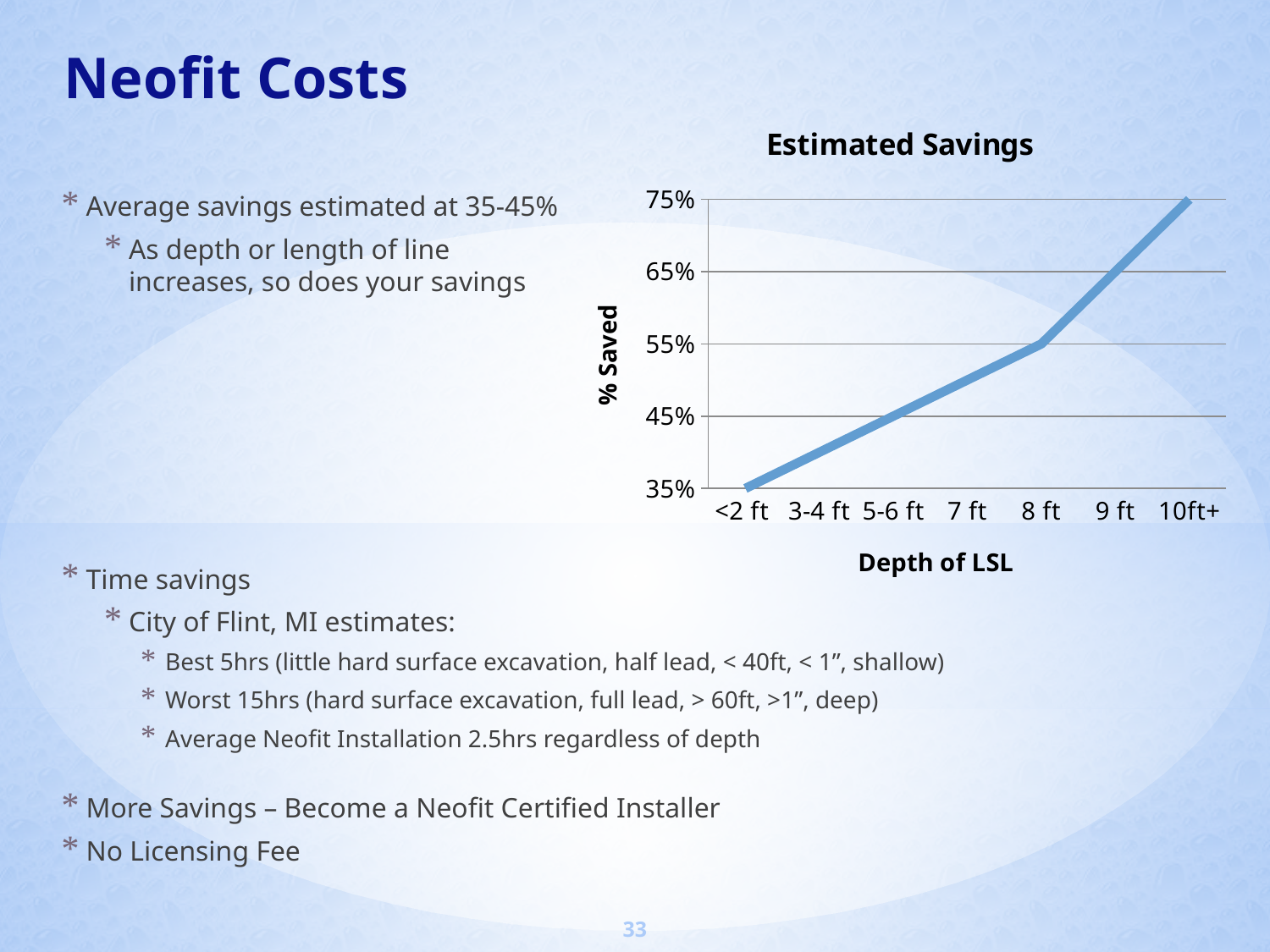
How many depth categories are shown on the x axis of the chart? 7 What is the label of the x axis of the chart? Depth of LSL Which has a higher % Saved, 8 ft or 3-4 ft? 8 ft What is the % Saved for a depth of <2 ft? 35% Which depth category has the highest % Saved? 10ft+ Which depth category has the lowest % Saved? <2 ft What kind of chart is shown on the slide? line chart Is the % Saved for 3-4 ft greater or less than 45%? less What is the % Saved for a depth of 10ft+? 75% What is the title of the chart? Estimated Savings Is the % Saved for 7 ft greater or less than 45%? greater Does the % Saved rise or fall as the depth of LSL increases? rise